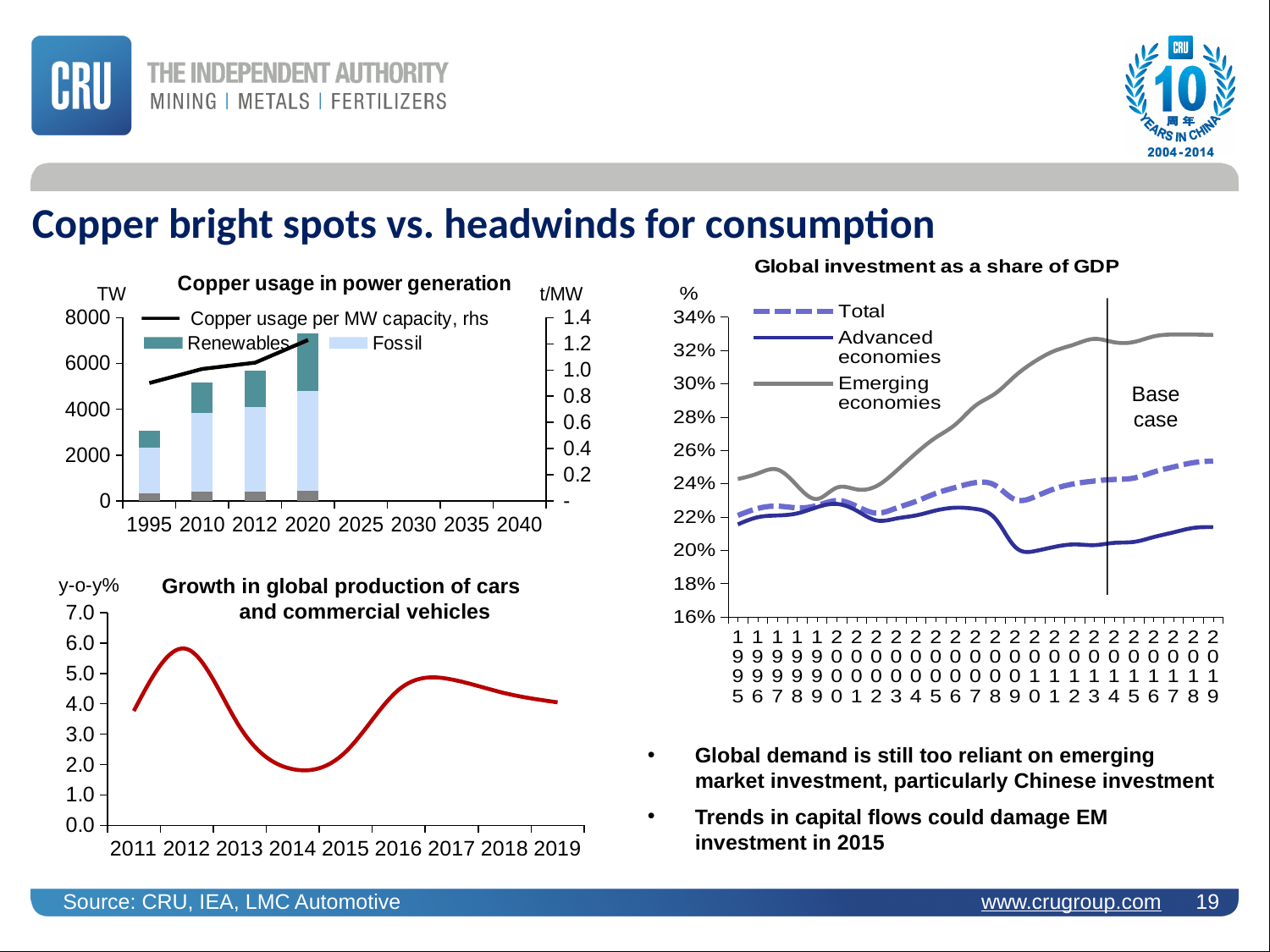
In 'Copper usage in power generation', what unit is shown on the right-hand axis? t/MW In 'Growth in global production of cars and commercial vehicles', which year has the lowest growth? 2014 What kind of chart is 'Global investment as a share of GDP'? line chart In 'Growth in global production of cars and commercial vehicles', which year has the highest growth? 2012 In 'Copper usage in power generation', is the total bar for 2020 greater or less than 6000? greater In 'Global investment as a share of GDP', is the value for Advanced economies in 2015 greater or less than 22%? less What kind of chart is 'Copper usage in power generation'? combination bar and line chart How many series does the legend of 'Global investment as a share of GDP' list? 3 In 'Growth in global production of cars and commercial vehicles', is the value for 2012 greater or less than 5.0? greater